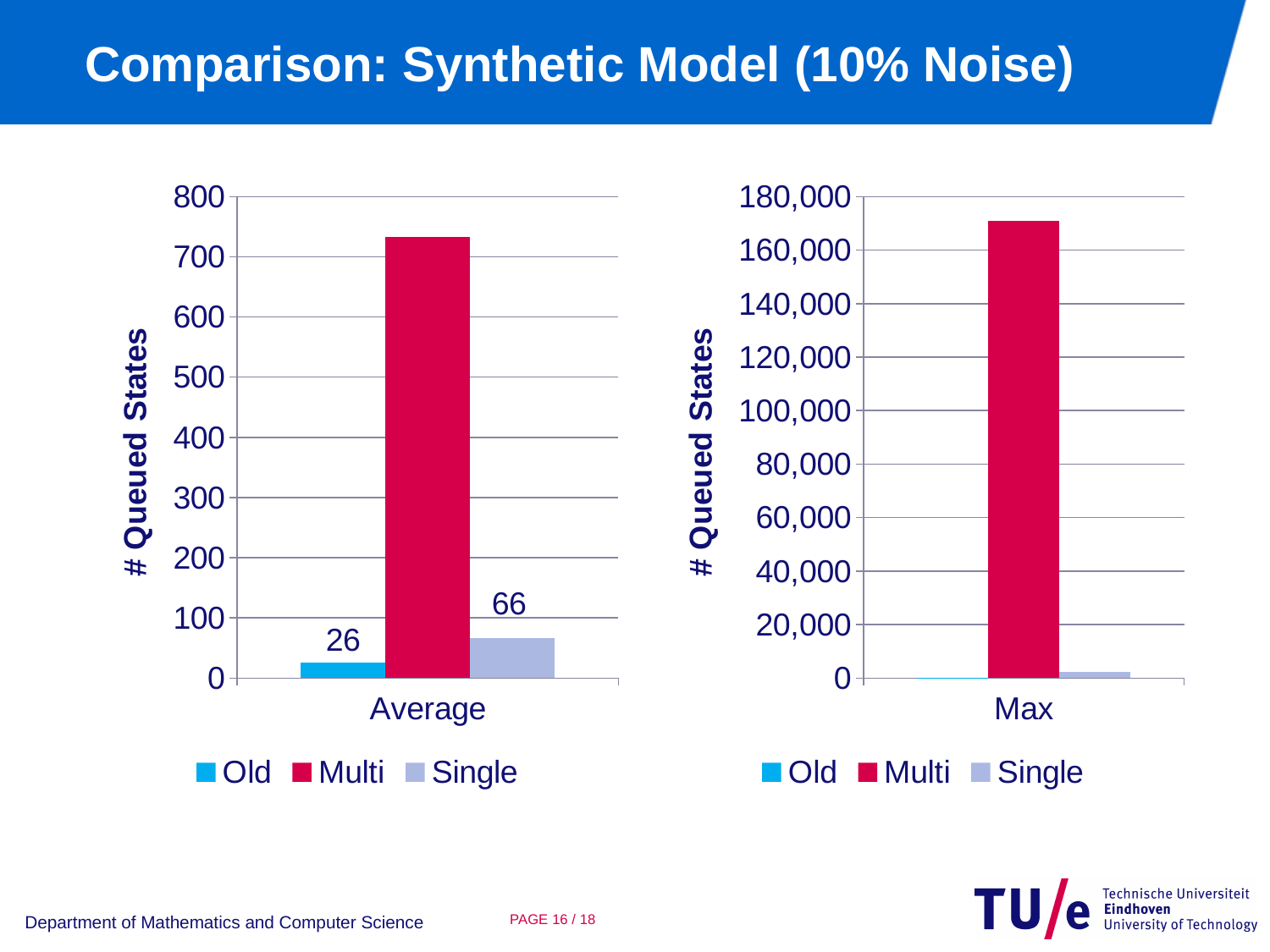
How many series does the legend of the left chart list? 3 In the right chart (Max), is the value for Multi greater or less than 160,000? greater In the left chart (Average), what is the value for Old? 26 What kind of chart is the right chart (Max)? bar chart In the right chart (Max), which series has the highest value? Multi In the left chart (Average), which series has the highest value? Multi In the left chart (Average), which series has the lowest value? Old In the right chart (Max), is the value for Single greater or less than 20,000? less In the left chart (Average), what is the value for Single? 66 In the left chart (Average), is the value for Multi greater or less than 700? greater In the left chart (Average), what is the difference between the Single and Old values? 40 In the left chart (Average), which is larger, the value for Single or the value for Old? Single